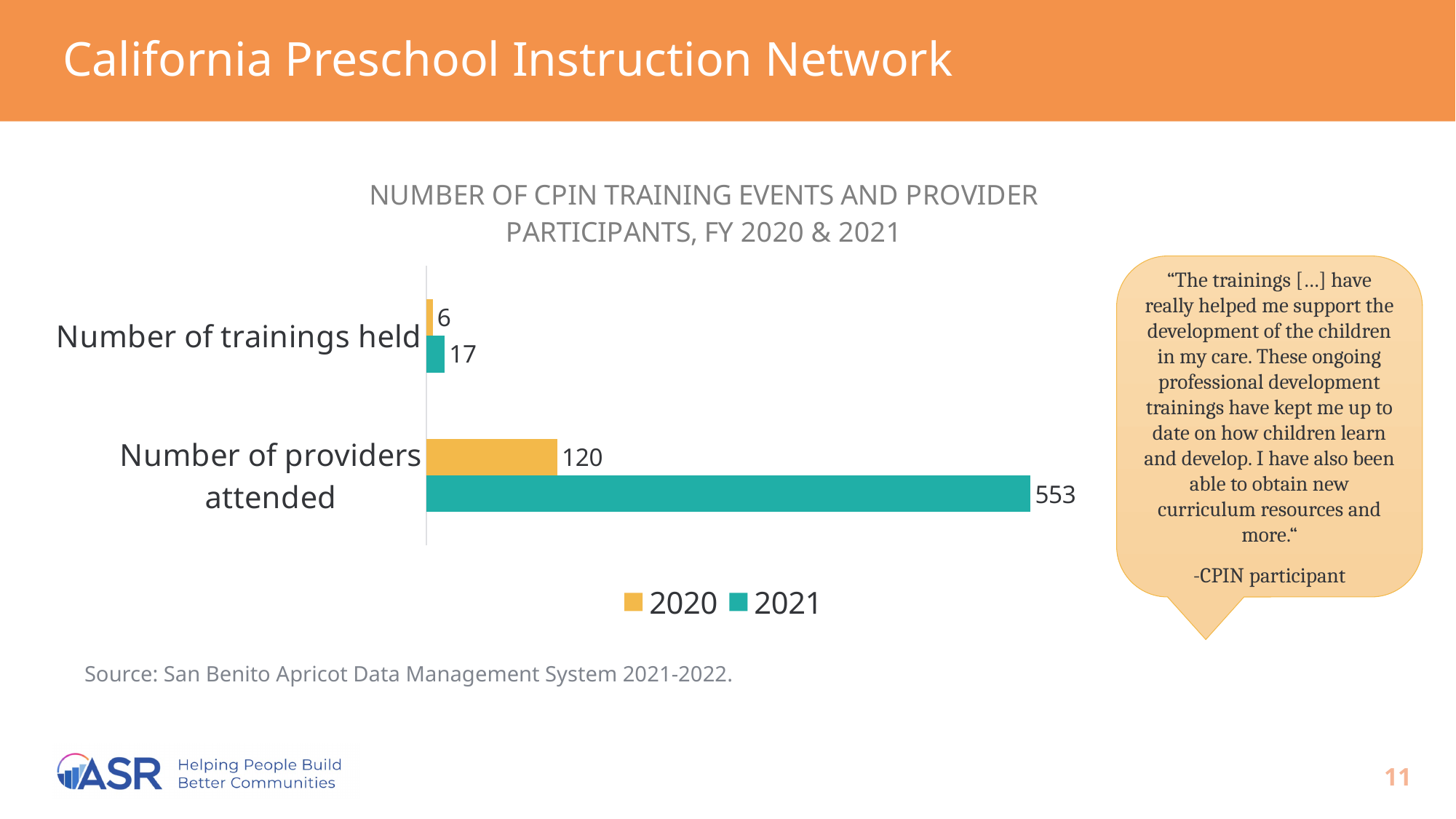
Which year had more trainings held, 2020 or 2021? 2021 How many more trainings were held in 2021 than in 2020? 11 How many more providers attended in 2021 than in 2020? 433 What type of chart is shown on the slide? Bar chart What was the number of trainings held in 2021? 17 What was the number of trainings held in 2020? 6 How many categories are shown on the chart? 2 Which colour represents 2021 in the chart? Teal How many series does the legend list? 2 What was the number of providers attended in 2020? 120 What was the number of providers attended in 2021? 553 Which bar in the chart has the highest value? Number of providers attended, 2021